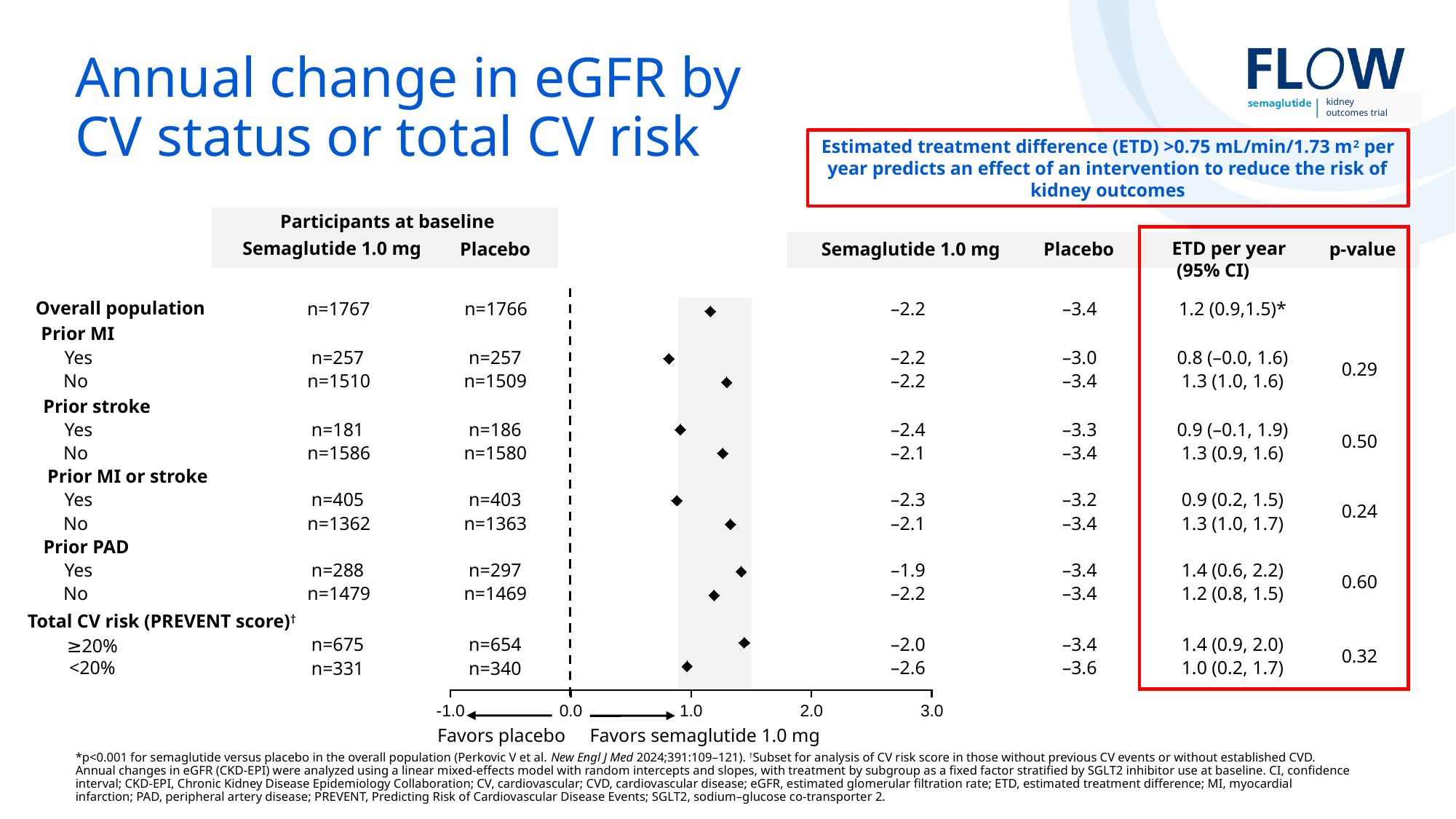
What kind of chart is shown on the slide? Forest plot How many point estimates are plotted in the forest plot? 11 Which subgroup comparison has the lowest p-value? Prior MI or stroke (0.24) Is the ETD per year for participants with prior MI (Yes) greater or less than 1.0? less What is the annual change in eGFR for placebo in participants with prior PAD (Yes)? –3.4 Which has the larger ETD per year: prior stroke Yes or prior stroke No? Prior stroke No (1.3) Which subgroup has the lowest ETD per year point estimate? Prior MI: Yes (0.8) Which direction on the x axis favors semaglutide 1.0 mg? To the right (values above 0.0) What is the annual change in eGFR for semaglutide 1.0 mg in participants with total CV risk (PREVENT score) <20%? –2.6 What is the difference between the semaglutide 1.0 mg and placebo annual eGFR change in the overall population? 1.2 What is the ETD per year (95% CI) for the overall population? 1.2 (0.9,1.5)* What is the p-value for the prior PAD subgroup comparison? 0.60